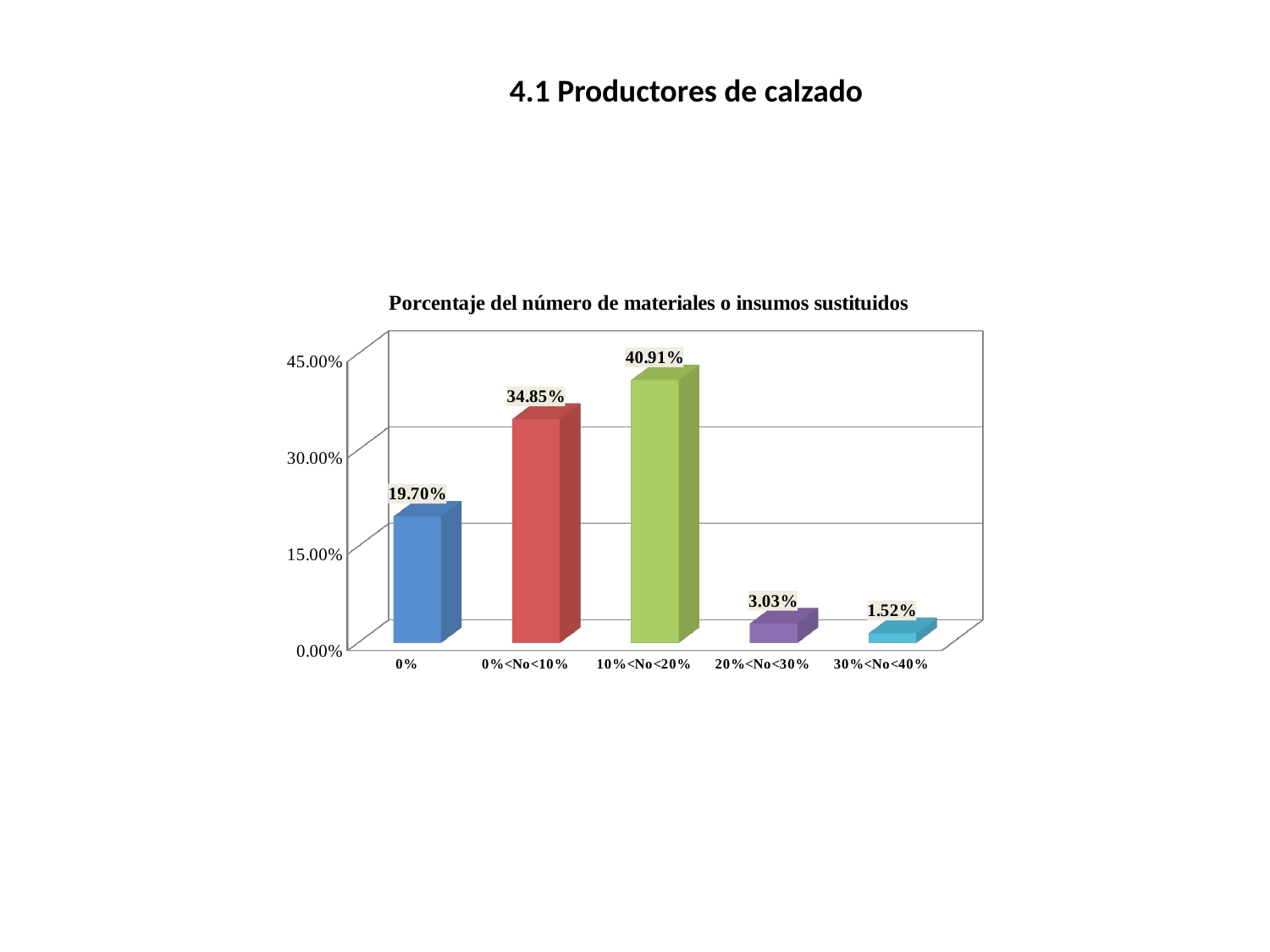
What is the value for the 0% category? 19.70% Which category has the highest value? 10%<No<20% Which is larger, the value for 0% or the value for 0%<No<10%? 0%<No<10% What kind of chart is shown on the slide? bar chart What colour is the bar for the 10%<No<20% category? green What is the title of the chart? Porcentaje del número de materiales o insumos sustituidos What is the value for the 30%<No<40% category? 1.52% Is the value for 20%<No<30% greater or less than 15.00%? less Which category has the lowest value? 30%<No<40% What is the value for the 10%<No<20% category? 40.91% What is the difference between the values for 10%<No<20% and 0%<No<10%? 6.06% How many categories are shown on the x axis? 5